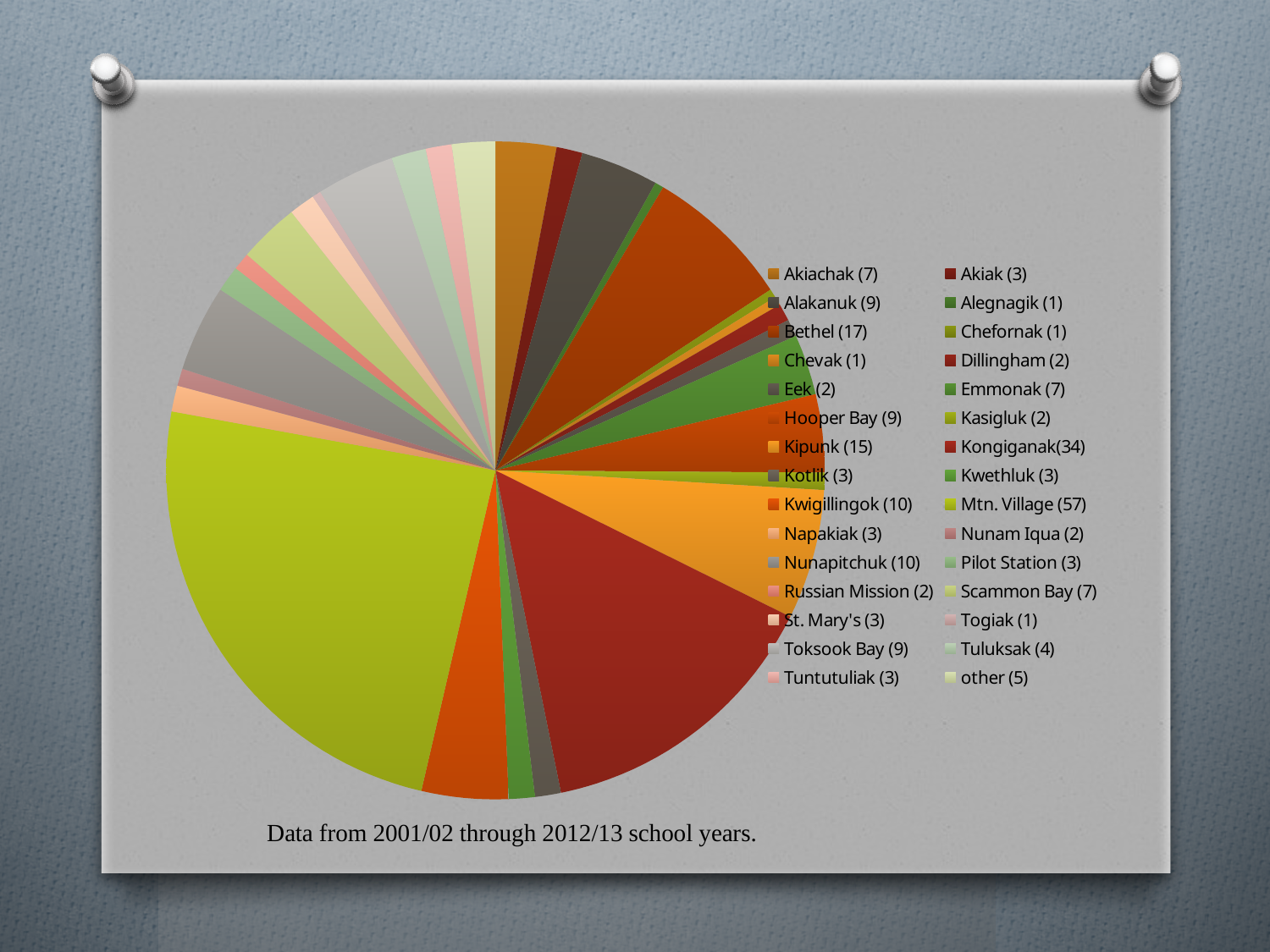
What value is shown for Kongiganak in the legend? 34 Which is larger, the value for Toksook Bay or the value for Tuluksak? Toksook Bay Which is larger, the value for Kwigillingok or the value for Hooper Bay? Kwigillingok What is the difference between the values for Bethel and Kipunk? 2 What value is shown for Bethel? 17 What is the difference between the values for Mtn. Village and Kongiganak? 23 How many categories are listed in the legend of the pie chart? 30 What value is shown for Kipunk? 15 What value is shown for the 'other' category? 5 Which category has the largest slice of the pie? Mtn. Village (57) What kind of chart is shown on the slide? pie chart What school years does the caption below the chart say the data covers? 2001/02 through 2012/13